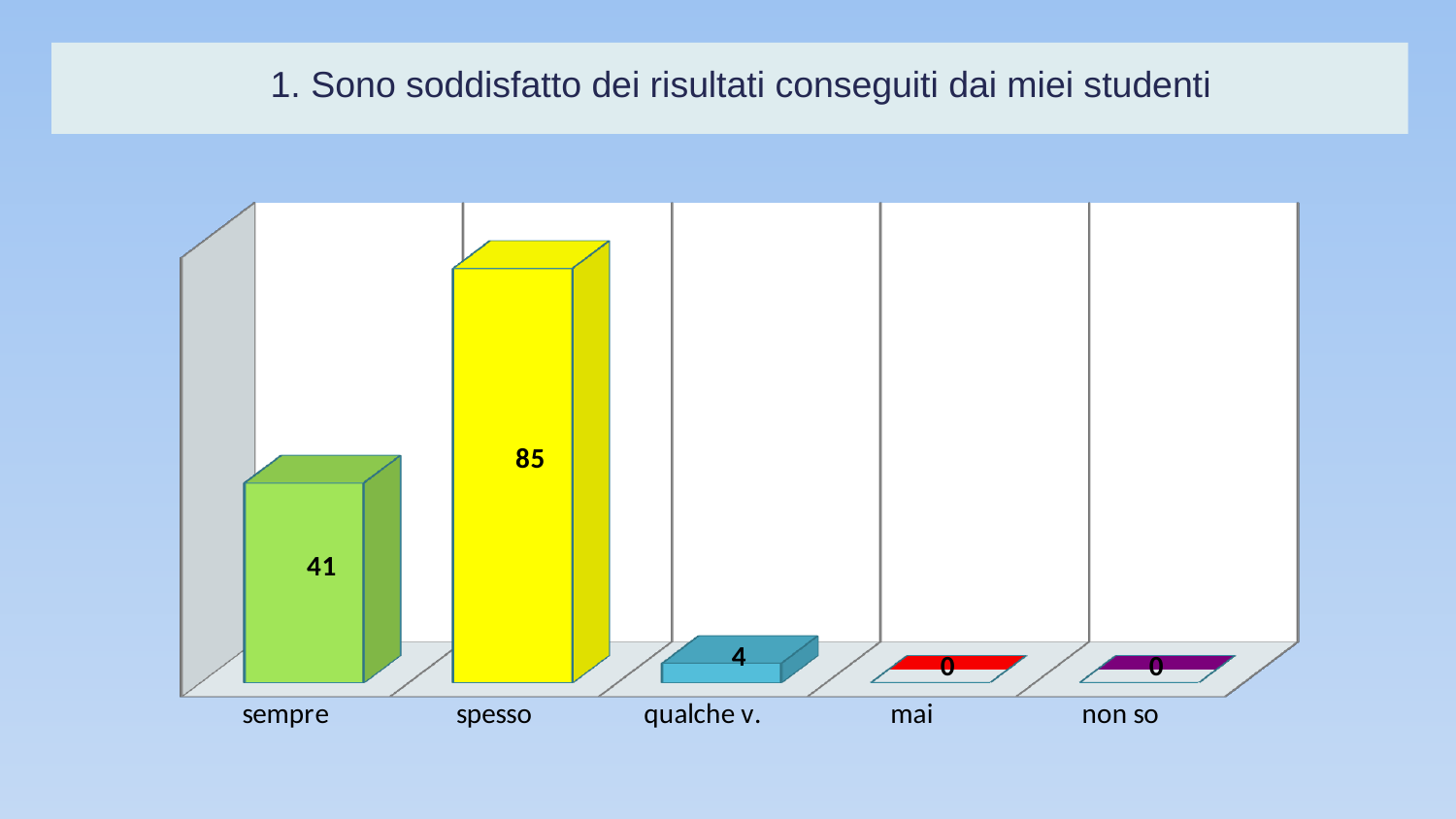
Which category has the highest value? spesso What is the value for "mai"? 0 What colour is the bar for "spesso"? yellow What is the difference between the values for "sempre" and "qualche v."? 37 Which is larger, the value for "sempre" or the value for "qualche v."? sempre What kind of chart is shown on the slide? bar chart What is the value for "spesso"? 85 What is the value for "qualche v."? 4 What is the value for "sempre"? 41 How many categories are shown on the x axis? 5 What is the title of the chart? 1. Sono soddisfatto dei risultati conseguiti dai miei studenti What is the difference between the values for "spesso" and "sempre"? 44